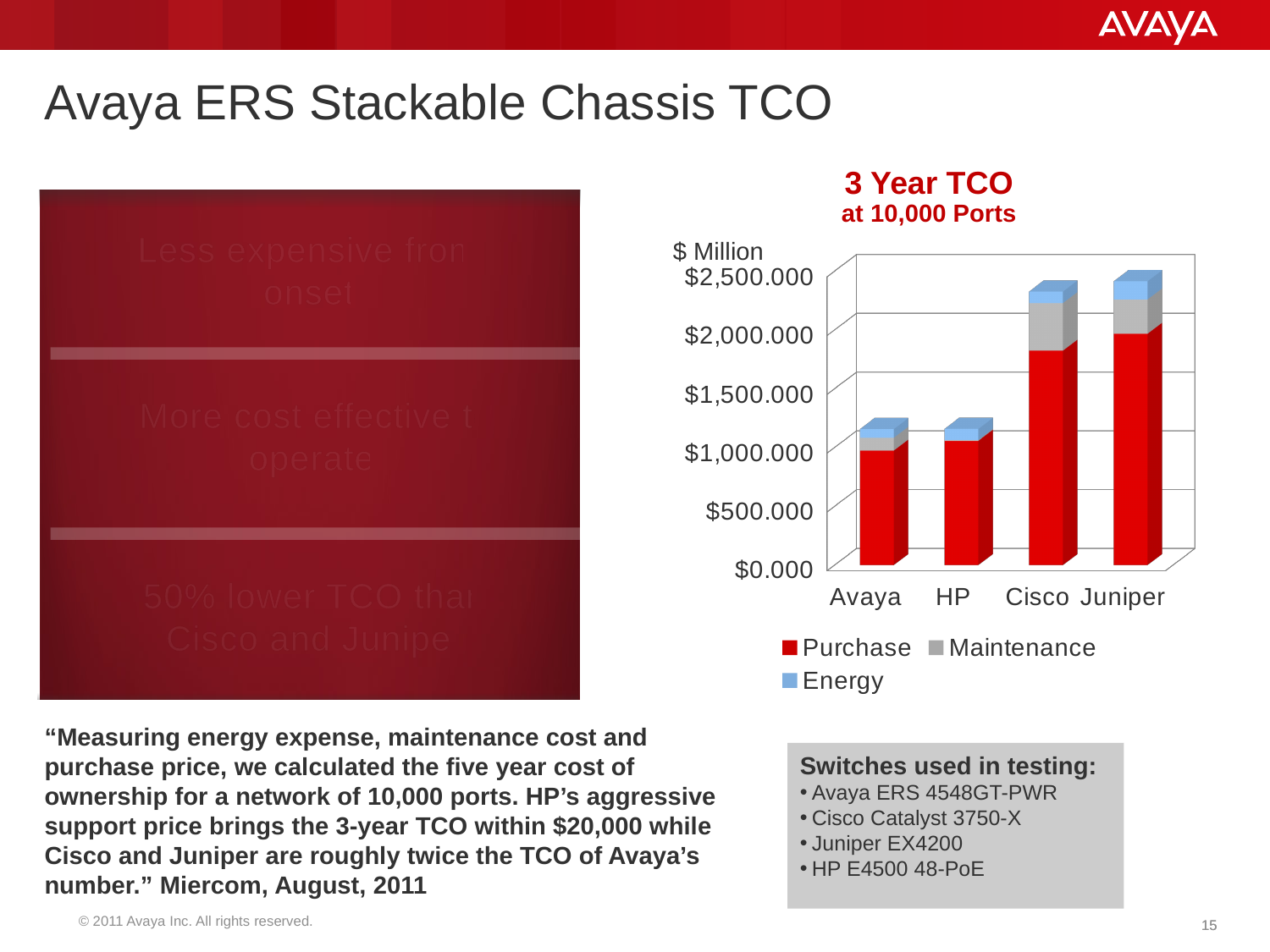
Is the total 3 Year TCO bar for Juniper greater or less than $2,000.000? greater How many series does the chart's legend list? 3 Is the total 3 Year TCO bar for HP greater or less than $1,500.000? less Is the total 3 Year TCO bar for Cisco greater or less than $2,000.000? greater What is the title of the chart? 3 Year TCO at 10,000 Ports Which has the larger total 3 Year TCO bar, HP or Juniper? Juniper Which has the larger total 3 Year TCO bar, Cisco or Avaya? Cisco What kind of chart is shown on the slide? bar chart How many vendors (categories) are shown on the x axis of the chart? 4 What unit label is shown on the chart's vertical axis? $ Million